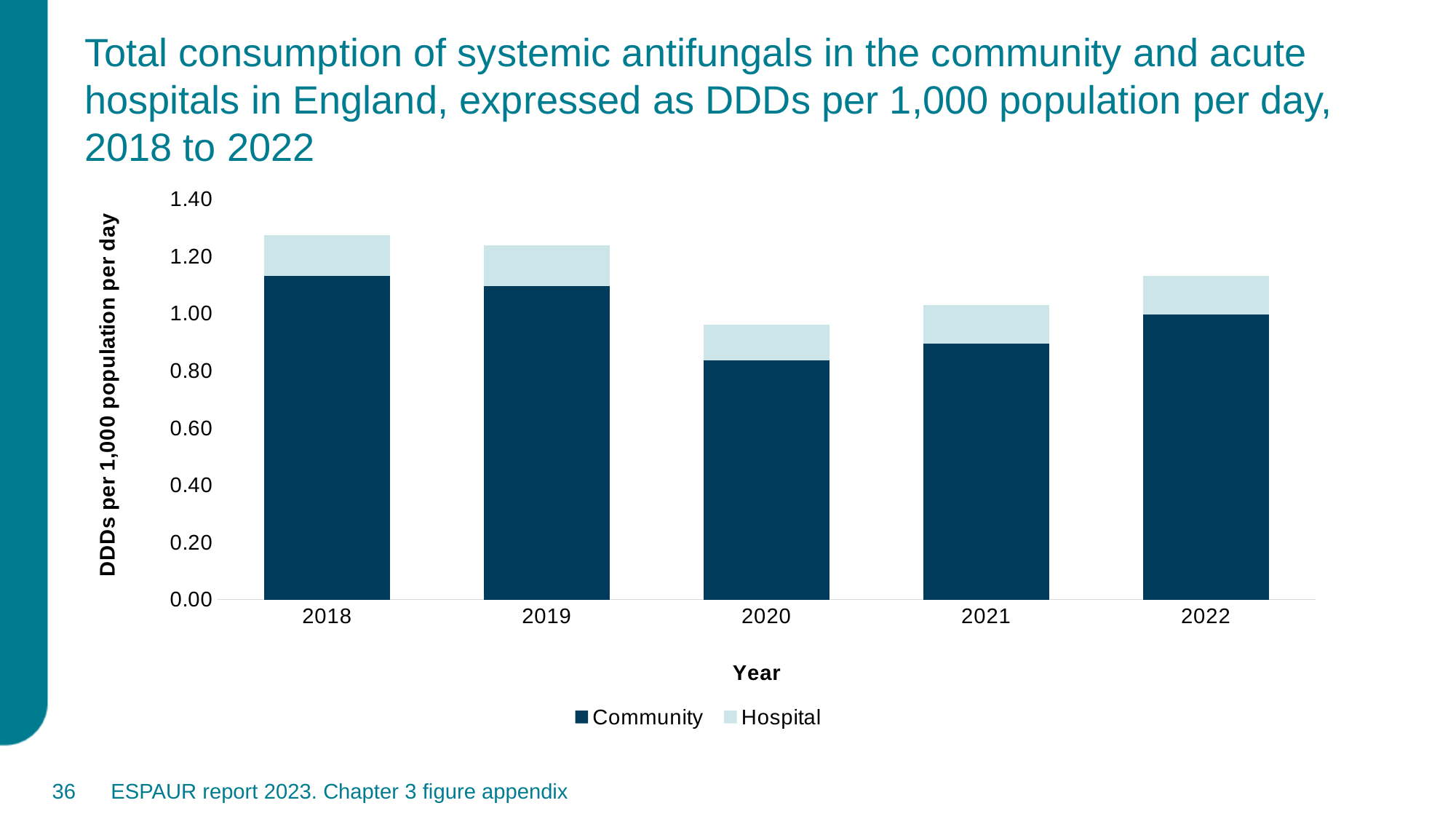
What kind of chart is shown on the slide? Stacked bar chart Is the total stacked bar for 2020 greater or less than 1.00? less Which year has the highest total consumption (Community plus Hospital)? 2018 How many years are shown on the x axis of the chart? 5 Which year has the lowest Community consumption? 2020 Is the total stacked bar for 2018 greater or less than 1.20? greater Which year has the lowest total consumption (Community plus Hospital)? 2020 Do the total stacked bars rise or fall from 2020 to 2022? rise Which is larger, the total stacked bar for 2018 or for 2022? 2018 Is the Community value for 2018 greater or less than 1.00? greater What is the label of the y axis? DDDs per 1,000 population per day How many series does the chart's legend list? 2